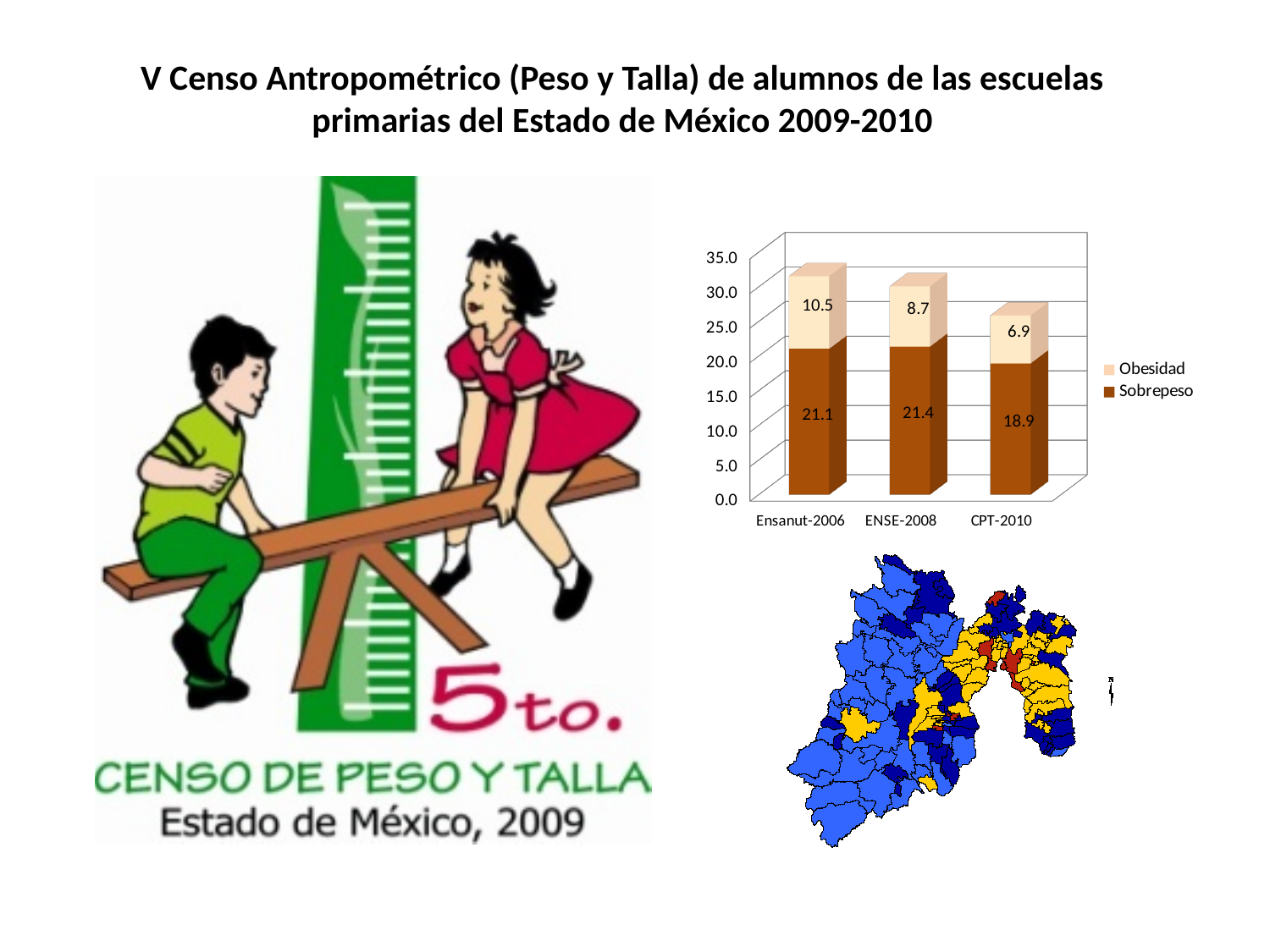
How many series does the chart legend list? 2 What kind of chart is shown on the slide? Stacked bar chart What is the total of the stacked bar for Ensanut-2006? 31.6 What is the Obesidad value for ENSE-2008? 8.7 What is the Obesidad value for CPT-2010? 6.9 How many categories are shown on the x axis of the chart? 3 What is the difference between the Obesidad values for Ensanut-2006 and CPT-2010? 3.6 What is the Sobrepeso value for CPT-2010? 18.9 What is the Sobrepeso value for Ensanut-2006? 21.1 Which category has the highest Obesidad value? Ensanut-2006 Which is larger, the Sobrepeso value for ENSE-2008 or for CPT-2010? ENSE-2008 Which category has the lowest Sobrepeso value? CPT-2010